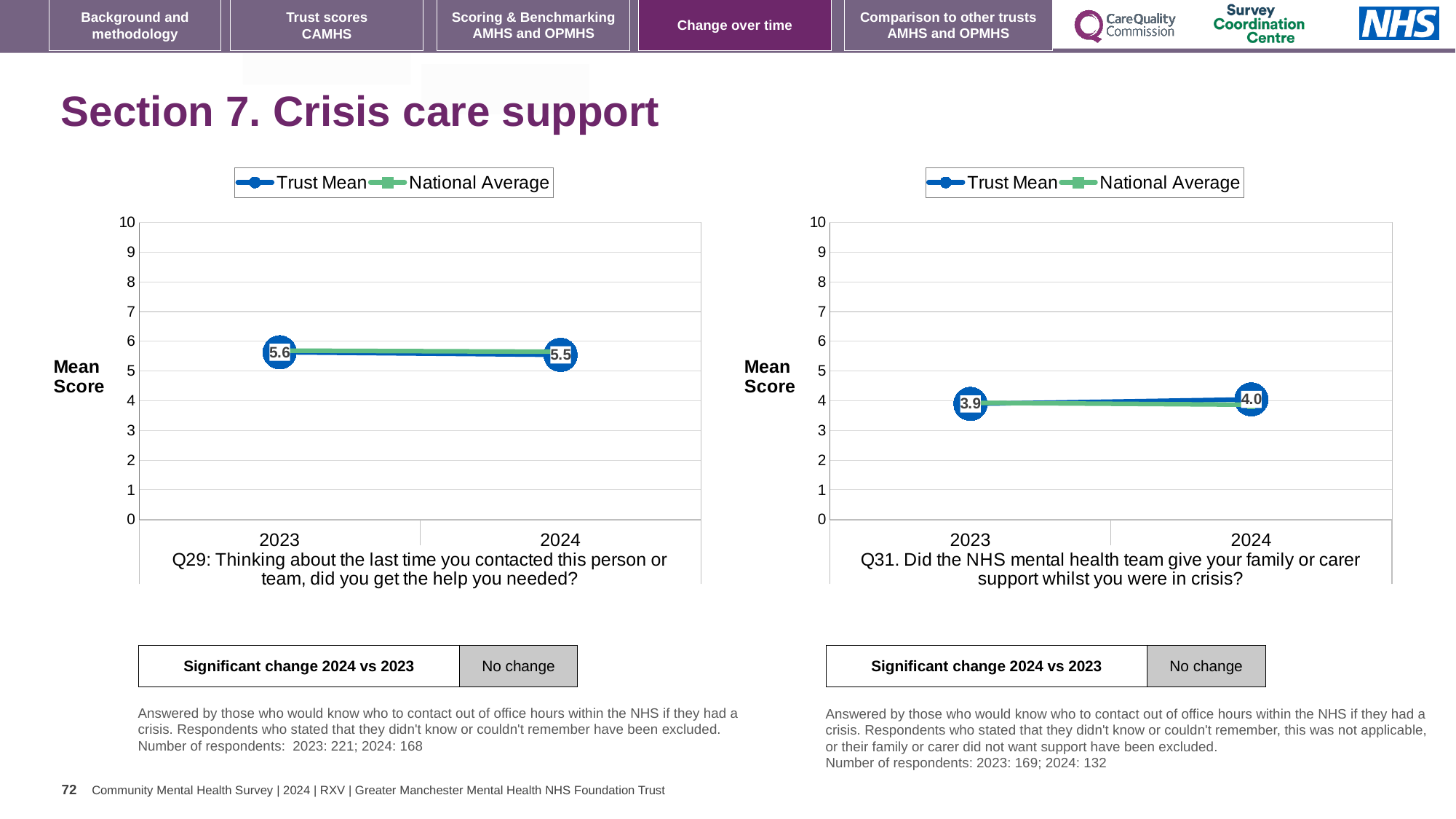
In the Q29 chart on the left, does the Trust Mean rise or fall from 2023 to 2024? fall How many series does the legend of the Q31 chart on the right list? 2 What are the two series named in the legend of the Q29 chart on the left? Trust Mean and National Average What kind of chart is the Q29 chart on the left? line chart In the Q31 chart on the right, what is the Trust Mean score for 2024? 4.0 In the Q31 chart on the right, is the Trust Mean for 2023 greater or less than 5? less In the Q31 chart on the right, does the Trust Mean rise or fall from 2023 to 2024? rise In the Q29 chart on the left, what is the difference between the Trust Mean scores for 2023 and 2024? 0.1 In the Q29 chart on the left, what is the Trust Mean score for 2023? 5.6 How many years are plotted on the x axis of the Q31 chart on the right? 2 In the Q29 chart on the left, what is the Trust Mean score for 2024? 5.5 In the Q31 chart on the right, what is the Trust Mean score for 2023? 3.9